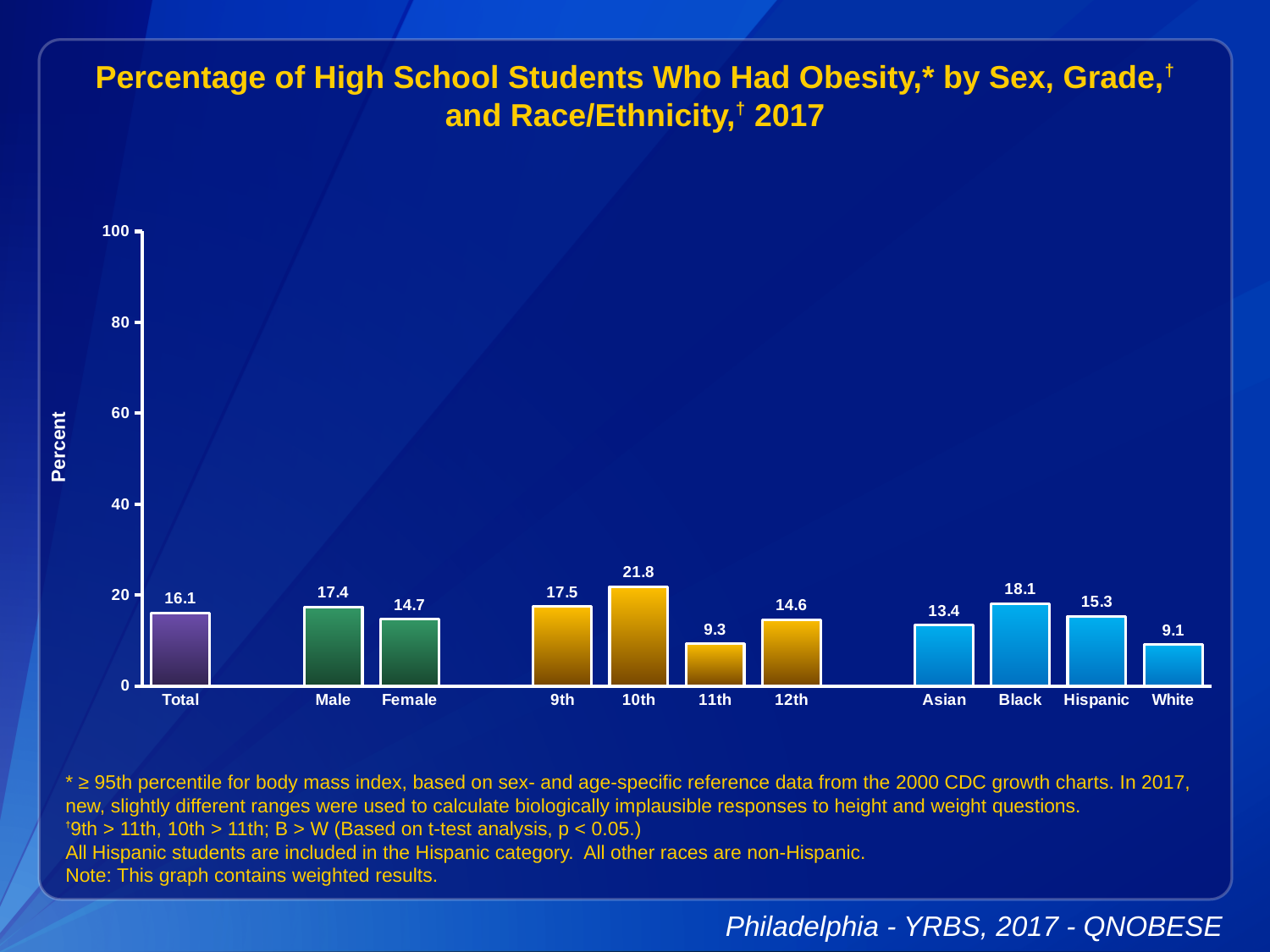
Which category has the lowest value? White What kind of chart is this? bar chart What is the value for Hispanic students? 15.3 What is the value for Total? 16.1 What is the value for 11th grade? 9.3 How many categories are shown on the x axis? 11 What is the value for Female? 14.7 What is the difference between the values for Male and Female? 2.7 Is the value for 10th grade greater or less than 20? greater Which is larger, the value for 9th grade or 12th grade? 9th Which category has the highest value? 10th What is the difference between the values for Black and White students? 9.0